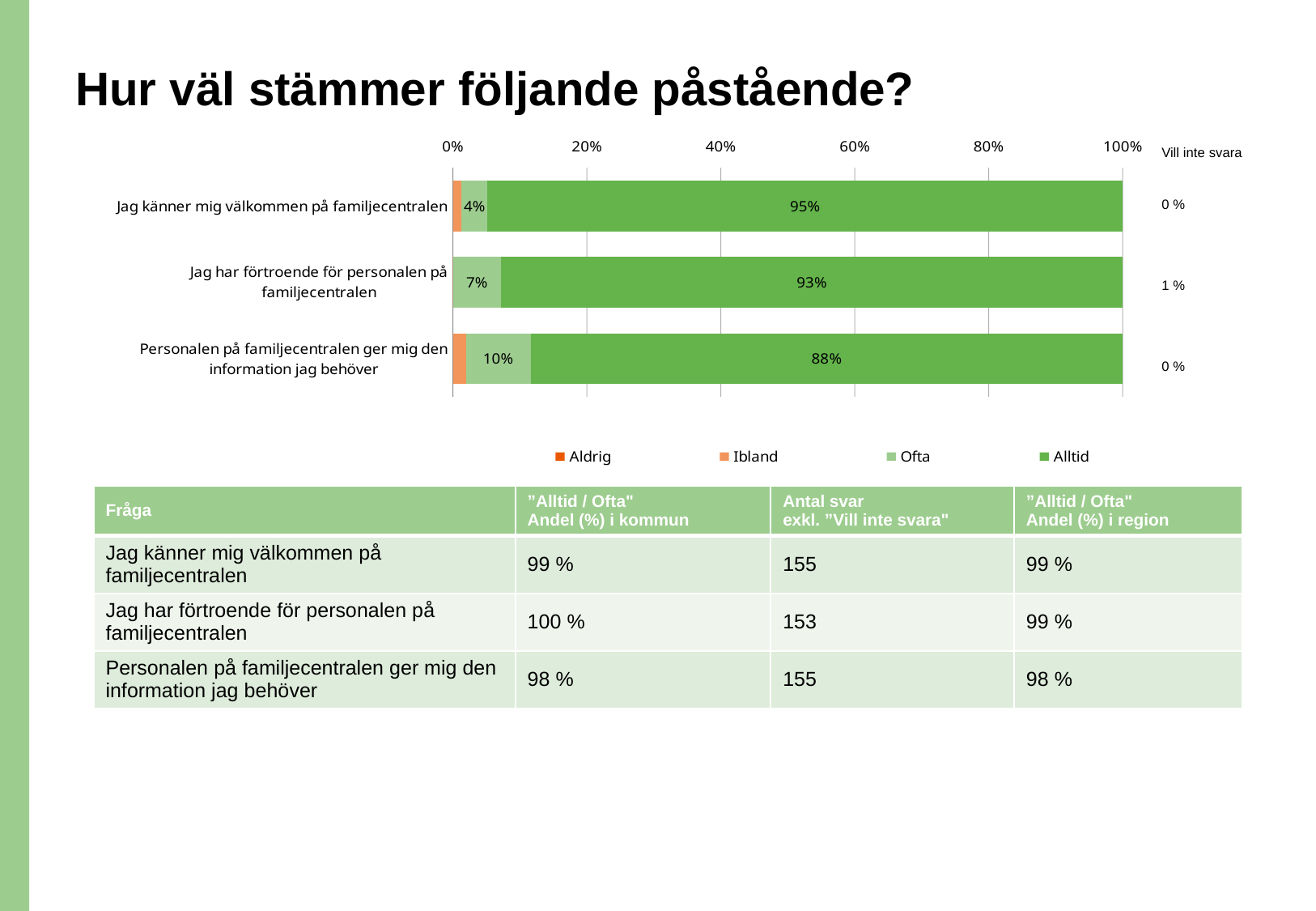
What is the "Ofta" value for "Personalen på familjecentralen ger mig den information jag behöver"? 10% What is the "Ofta" value for "Jag har förtroende för personalen på familjecentralen"? 7% Which is larger: the "Ofta" value for "Jag har förtroende för personalen på familjecentralen" or for "Personalen på familjecentralen ger mig den information jag behöver"? Personalen på familjecentralen ger mig den information jag behöver What is the "Alltid" value for "Jag känner mig välkommen på familjecentralen"? 95% Which statement has the lowest "Alltid" value? Personalen på familjecentralen ger mig den information jag behöver What is the difference between the "Alltid" values for "Jag känner mig välkommen på familjecentralen" and "Personalen på familjecentralen ger mig den information jag behöver"? 7% Which statement has the highest "Alltid" value? Jag känner mig välkommen på familjecentralen Is the "Alltid" value for "Jag har förtroende för personalen på familjecentralen" greater or less than 80%? greater What is the "Alltid" value for "Personalen på familjecentralen ger mig den information jag behöver"? 88% What kind of chart is shown on the slide? Stacked bar chart How many statements (categories) are shown in the chart? 3 How many series does the chart legend list? 4